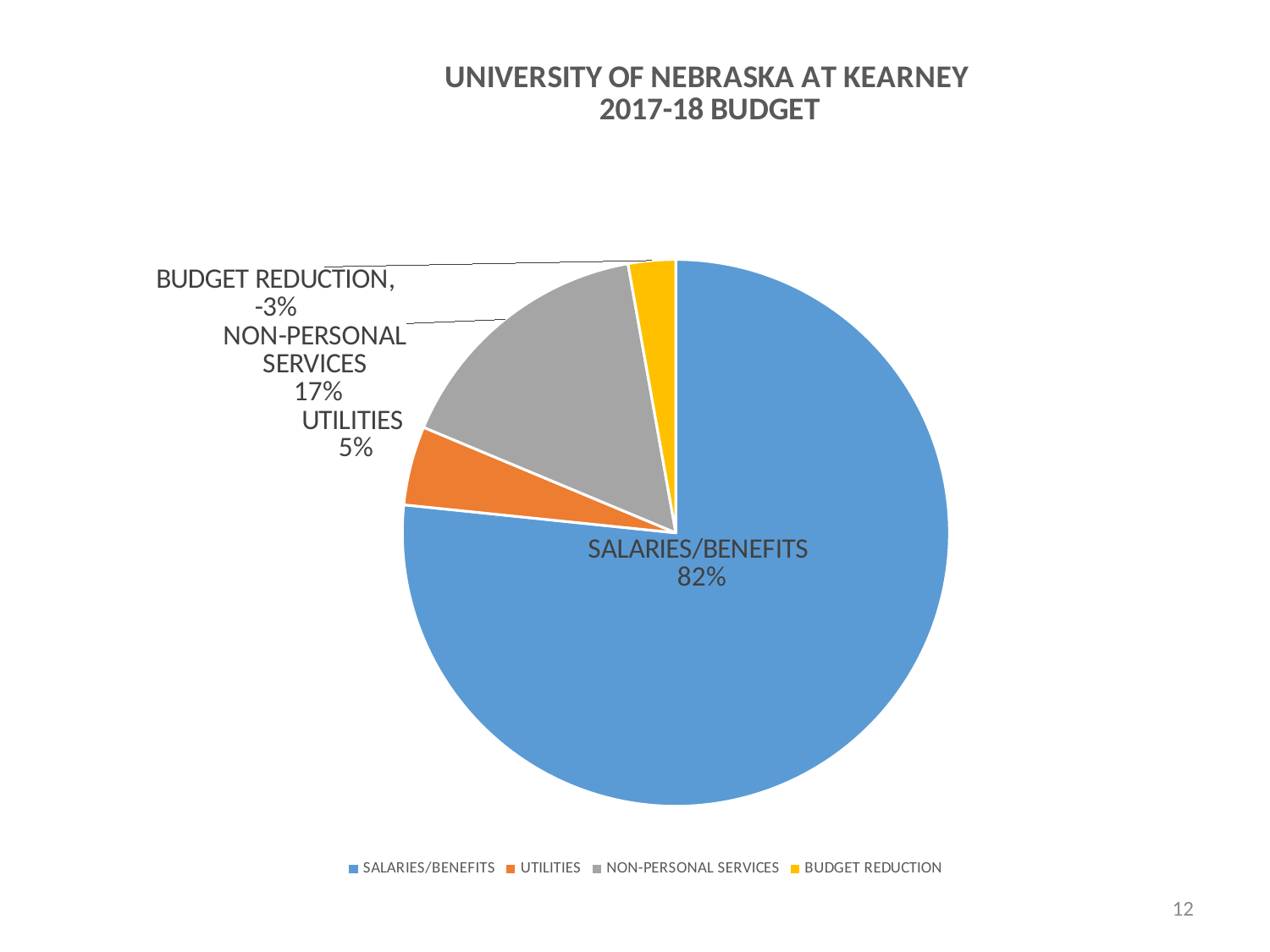
What share of the budget is Salaries/Benefits? 82% What value is shown for Budget Reduction? -3% What is the difference in percentage points between Salaries/Benefits and Non-Personal Services? 65 percentage points Which is larger, Non-Personal Services or Utilities? NON-PERSONAL SERVICES How many categories does the pie chart show? 4 Which category has the largest slice of the pie? SALARIES/BENEFITS What share of the budget is Non-Personal Services? 17% What colour is the Salaries/Benefits slice? Blue What is the title of the chart? UNIVERSITY OF NEBRASKA AT KEARNEY 2017-18 BUDGET Which category has the smallest value in the chart? BUDGET REDUCTION What share of the budget is Utilities? 5% What type of chart is shown on the slide? Pie chart